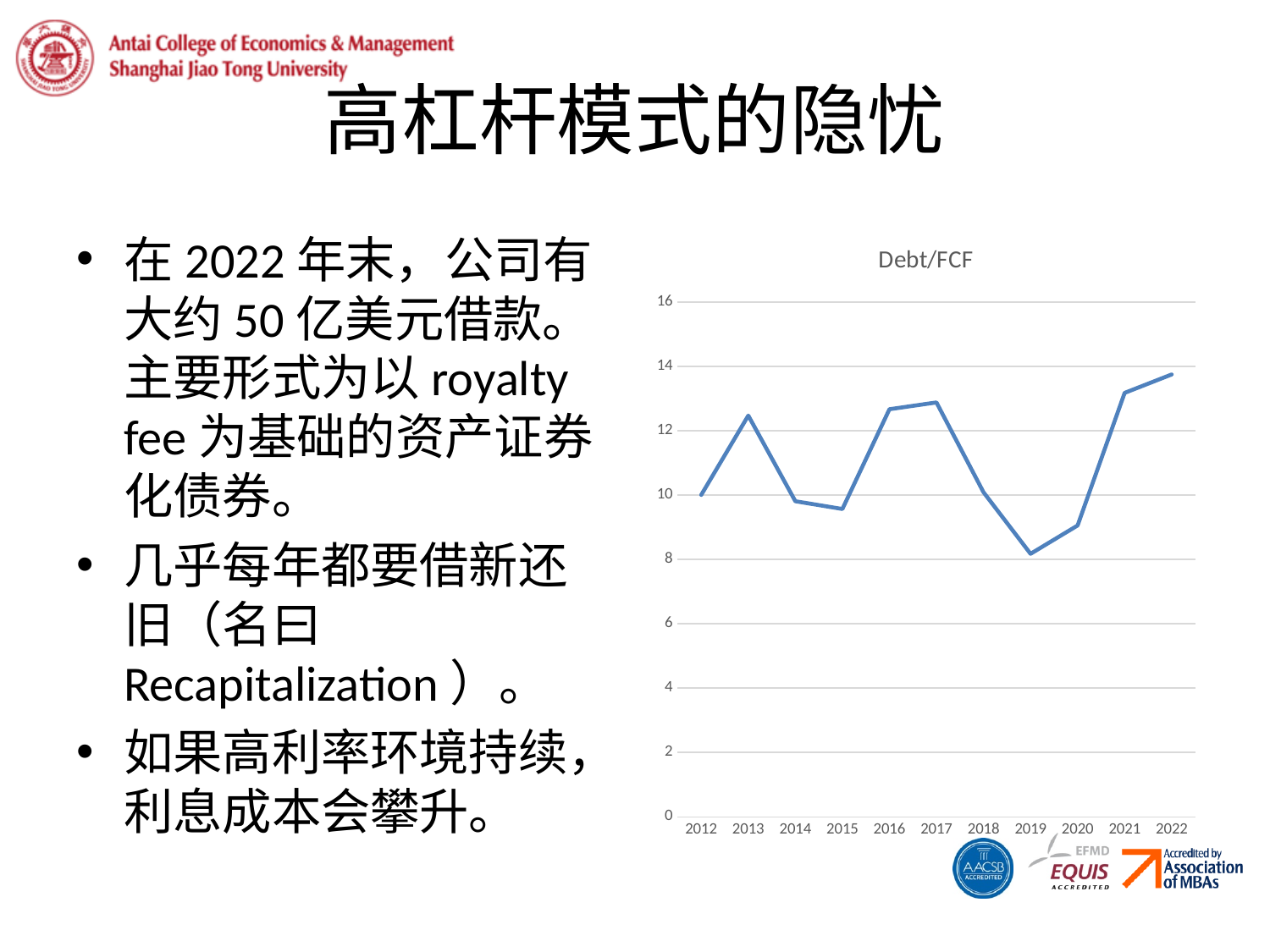
Does the Debt/FCF value rise or fall from 2019 to 2022? rise Is the Debt/FCF value for 2019 greater or less than 10? less How many years are plotted on the x axis of the Debt/FCF chart? 11 Which year has the lowest Debt/FCF value? 2019 Is the Debt/FCF value for 2015 greater or less than 10? less What is the title of the chart? Debt/FCF Is the Debt/FCF value for 2013 greater or less than 12? greater Which year has the highest Debt/FCF value? 2022 Which year has a higher Debt/FCF value, 2020 or 2021? 2021 Which year has a higher Debt/FCF value, 2016 or 2018? 2016 What kind of chart is shown on the slide? line chart